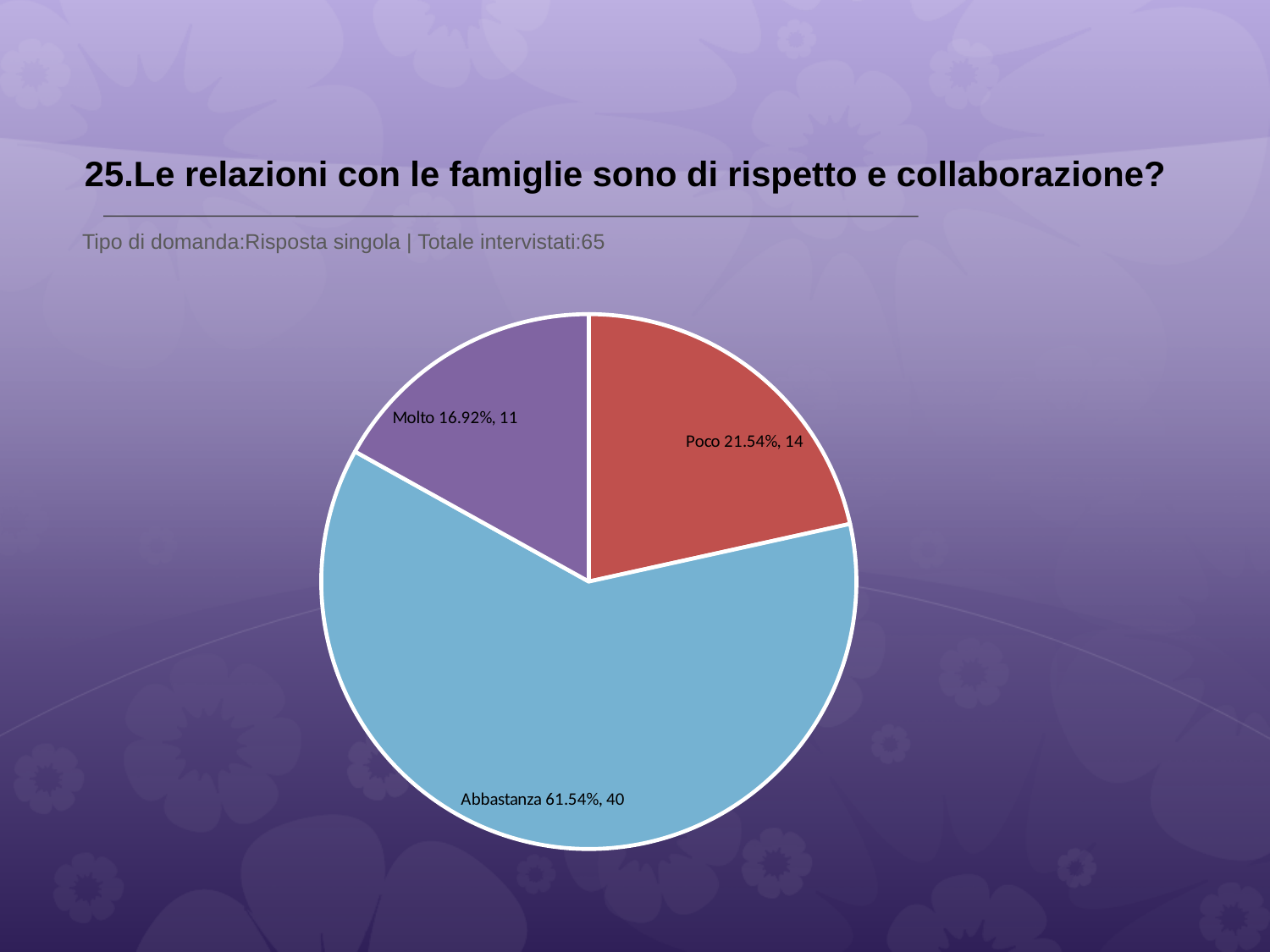
What percentage share does Abbastanza have? 61.54% What is the total count across all three slices? 65 What colour is the Abbastanza slice? light blue What is the difference in count between Abbastanza and Poco? 26 Which category has the smallest slice? Molto What percentage share does Poco have? 21.54% What kind of chart is shown on the slide? pie chart How many slices does the pie chart have? 3 What is the count for Molto? 11 Which category has the largest slice? Abbastanza What is the count for Abbastanza? 40 Which is larger, the count for Poco or the count for Molto? Poco